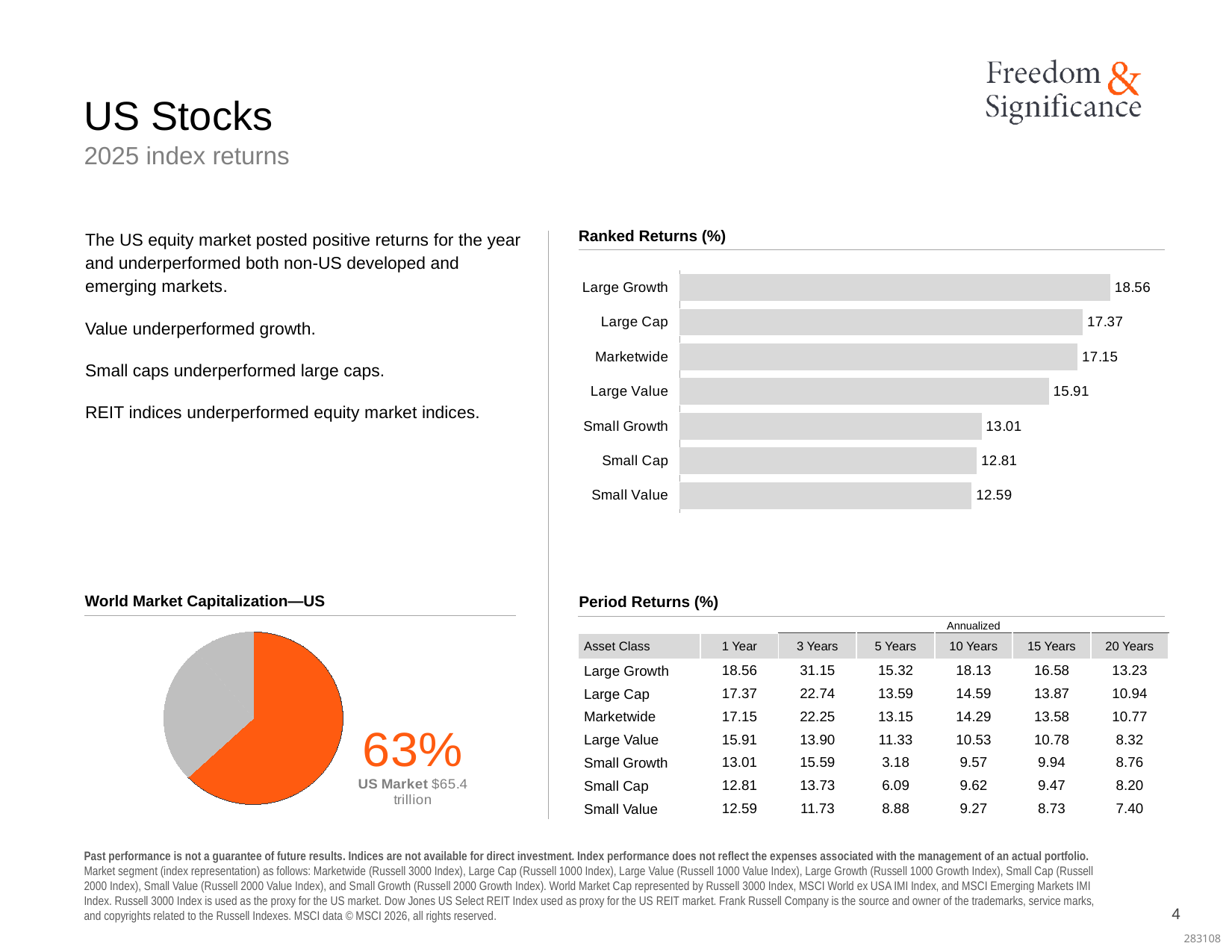
In the Ranked Returns (%) chart, which is larger, Large Value or Small Growth? Large Value In the Ranked Returns (%) chart, what is the difference between Large Growth and Small Value? 5.97 In the World Market Capitalization—US pie chart, what share does the US Market represent? 63% How many categories are shown in the Ranked Returns (%) chart? 7 In the Ranked Returns (%) chart, what is the value for Large Growth? 18.56 In the Ranked Returns (%) chart, what is the value for Small Cap? 12.81 In the Ranked Returns (%) chart, which category has the highest value? Large Growth In the Ranked Returns (%) chart, which category has the lowest value? Small Value In the Ranked Returns (%) chart, what is the difference between Large Cap and Small Cap? 4.56 What kind of chart is the World Market Capitalization—US chart? Pie chart What kind of chart is the Ranked Returns (%) chart? Bar chart In the Ranked Returns (%) chart, what is the value for Marketwide? 17.15